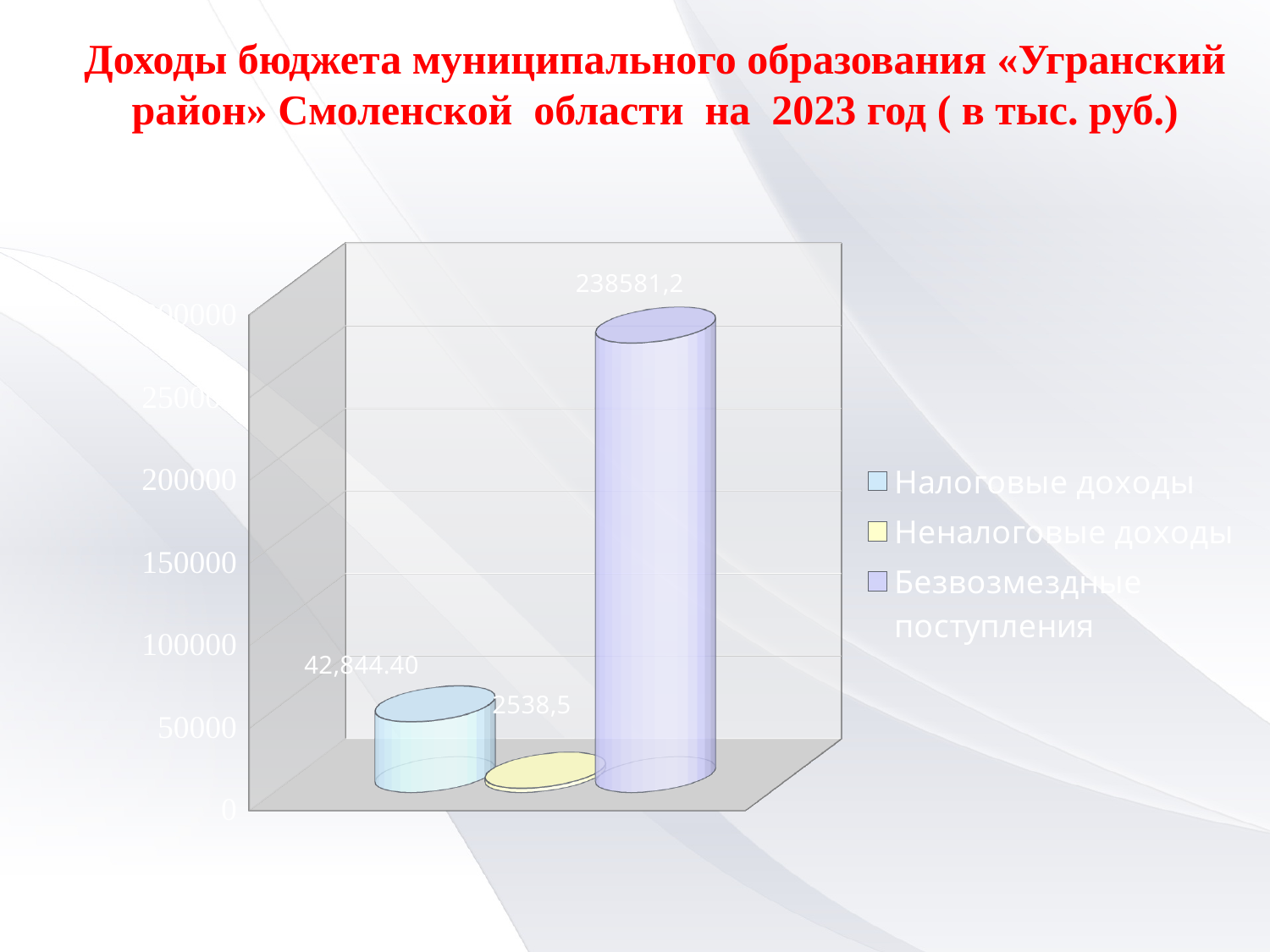
What is the value shown for Налоговые доходы? 42,844.40 How many series does the legend list? 3 What kind of chart is shown on the slide? Bar chart Which is larger, Налоговые доходы or Неналоговые доходы? Налоговые доходы What is the value shown for Неналоговые доходы? 2538,5 What is the difference between Безвозмездные поступления and Налоговые доходы? 195736.8 What is the value shown for Безвозмездные поступления? 238581,2 Which series has the highest value? Безвозмездные поступления Is the value for Налоговые доходы greater or less than 50000? less What is the highest value shown on the vertical axis? 300000 Which series has the lowest value? Неналоговые доходы Is the value for Безвозмездные поступления greater or less than 200000? greater